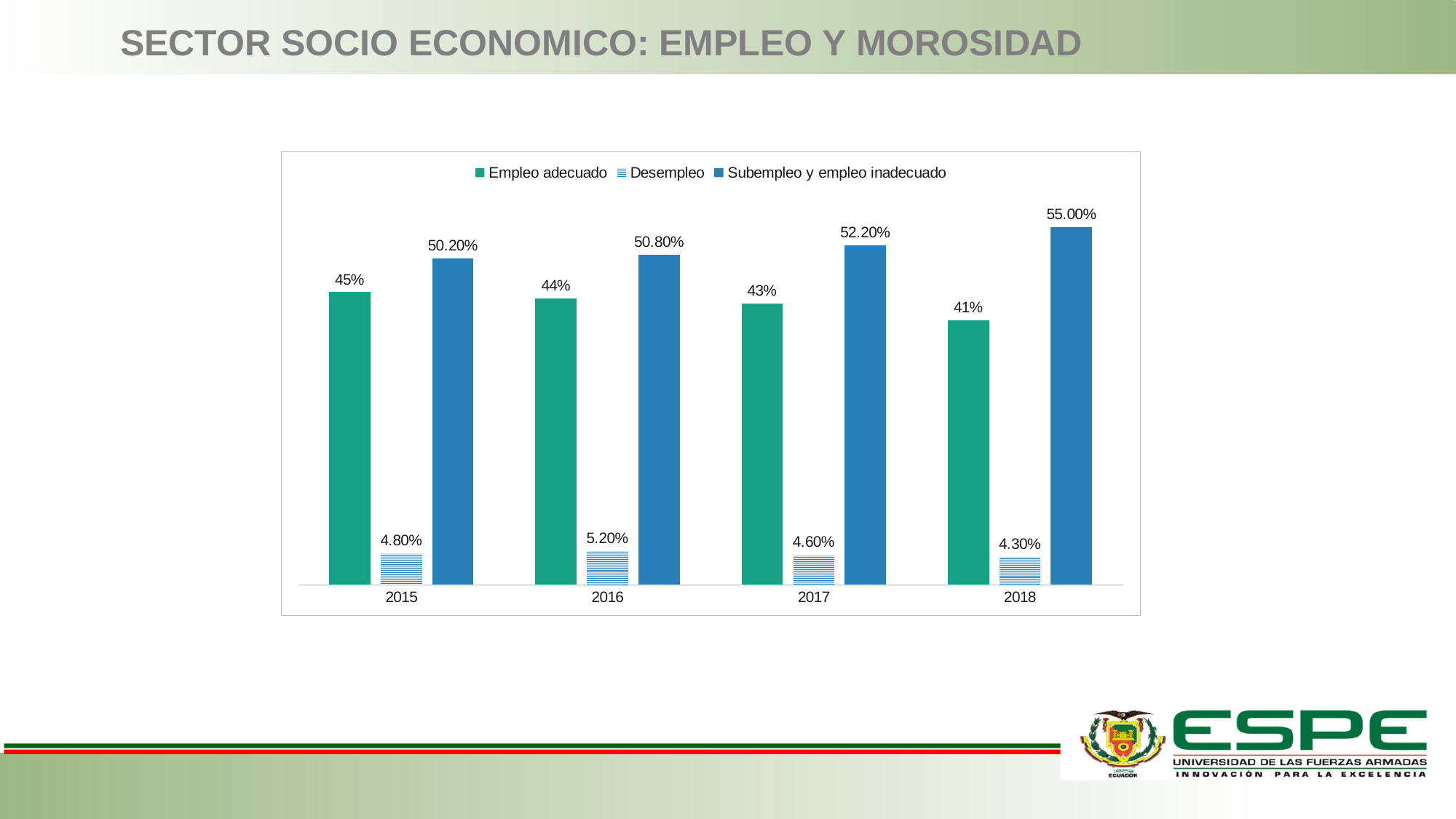
What kind of chart is shown on the slide? Bar chart What is the value for Subempleo y empleo inadecuado in 2018? 55.00% In which year is Subempleo y empleo inadecuado highest? 2018 How many series does the legend list? 3 What is the difference between Subempleo y empleo inadecuado and Empleo adecuado in 2018? 14.00% In which year is Desempleo lowest? 2018 What is the value for Subempleo y empleo inadecuado in 2017? 52.20% Does Empleo adecuado rise or fall from 2015 to 2018? Fall Which is larger in 2015: Empleo adecuado or Subempleo y empleo inadecuado? Subempleo y empleo inadecuado What is the value for Desempleo in 2016? 5.20% What is the value for Empleo adecuado in 2015? 45% How many years are shown on the x axis? 4